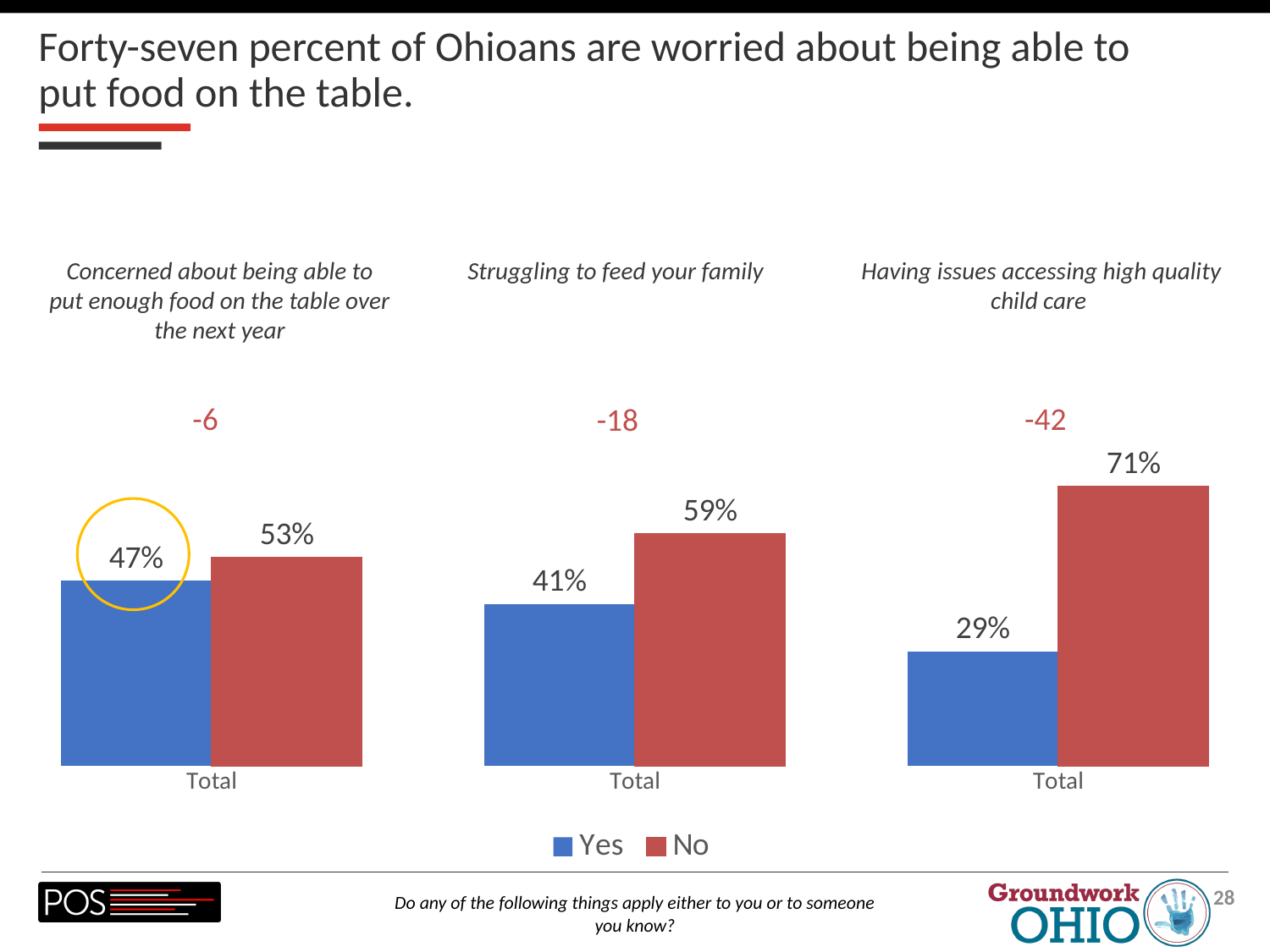
In the 'Concerned about being able to put enough food on the table over the next year' chart, which series has the lower value? Yes What kind of chart is the 'Struggling to feed your family' chart? Bar chart In the 'Having issues accessing high quality child care' chart, what is the difference between the No and Yes values? 42 In the 'Having issues accessing high quality child care' chart, what is the value for Yes? 29% In the 'Struggling to feed your family' chart, what is the value for Yes? 41% What colour represents the No series in the charts? Red In the 'Having issues accessing high quality child care' chart, what is the value for No? 71% How many series does the legend list? 2 In the 'Struggling to feed your family' chart, which is larger, Yes or No? No In the 'Concerned about being able to put enough food on the table over the next year' chart, what is the value for Yes? 47% In the 'Struggling to feed your family' chart, what is the value for No? 59% In the 'Concerned about being able to put enough food on the table over the next year' chart, what is the value for No? 53%